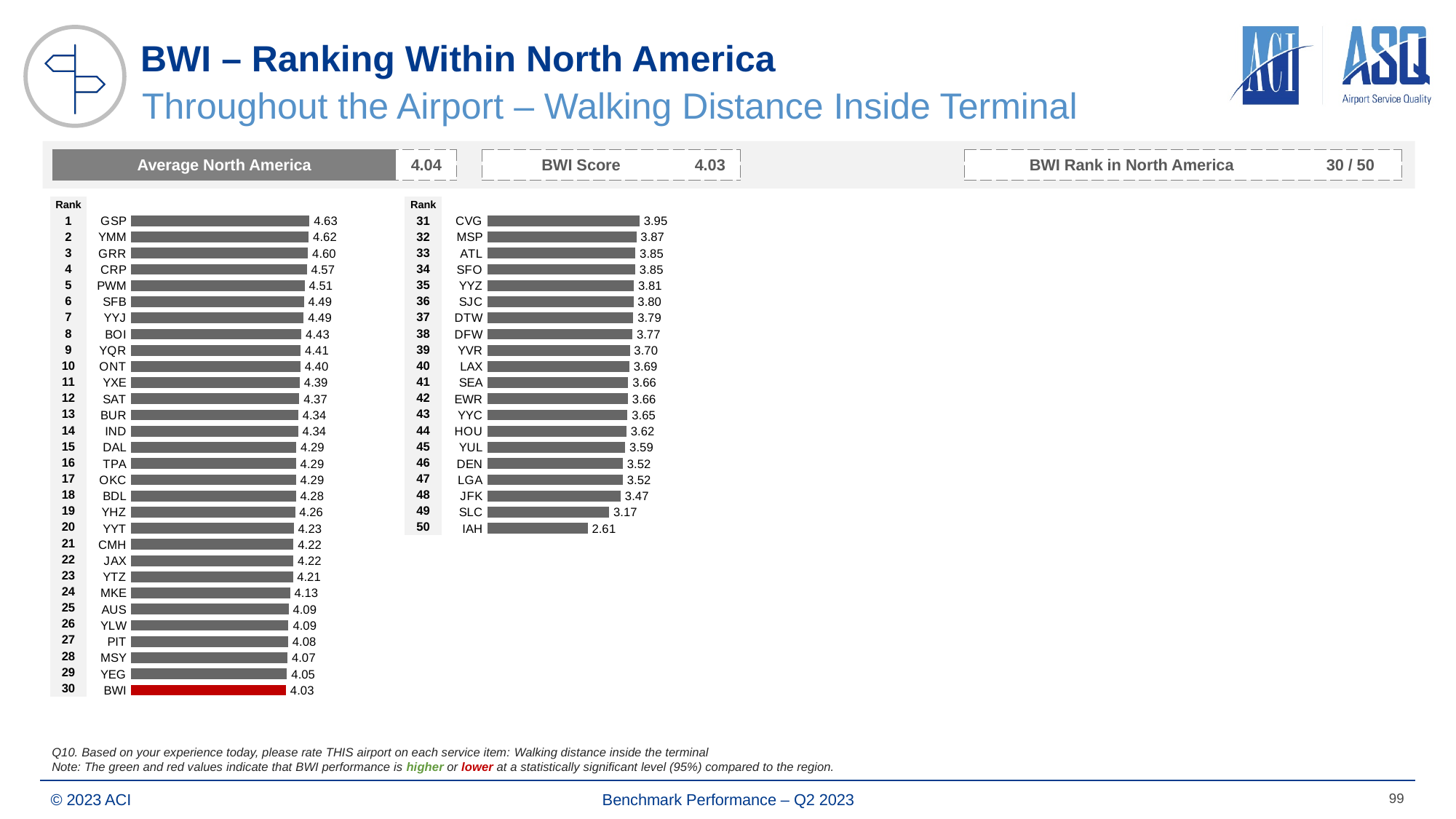
What is the difference between the scores of GSP and IAH? 2.02 What type of chart is shown on the slide? Bar chart How many airports are ranked in the chart? 50 What is the difference between the BWI score and the Average North America score? 0.01 Which airport has the lowest score? IAH What is the score for GSP? 4.63 Which has a higher score, SLC or JFK? JFK Which airport has the highest score? GSP What is BWI's rank in North America? 30 / 50 What is the score for IAH? 2.61 What is the score for DFW? 3.77 What is the score for BWI? 4.03